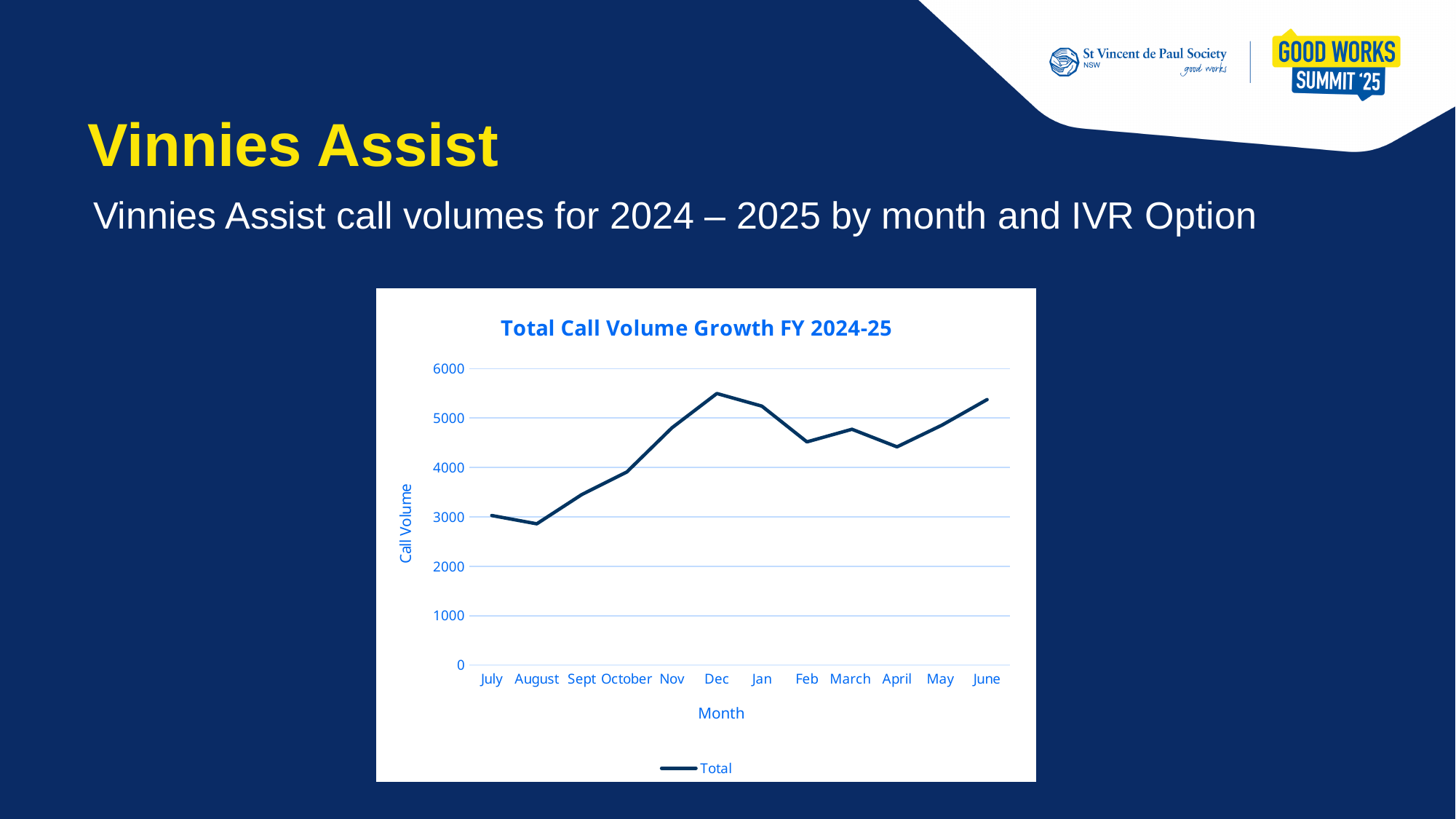
Which month has the highest total call volume? Dec How many months are plotted along the x axis of the chart? 12 Is the call volume for Dec greater or less than 5000? greater What is the title of the chart? Total Call Volume Growth FY 2024-25 What kind of chart is shown on the slide? line chart Does the call volume rise or fall from July to Dec? rise Is the call volume for Feb greater or less than 4000? greater Is the call volume for August greater or less than 3000? less Which month has the lowest total call volume? August How many series does the chart's legend list? 1 Which month has the higher call volume, Dec or Feb? Dec